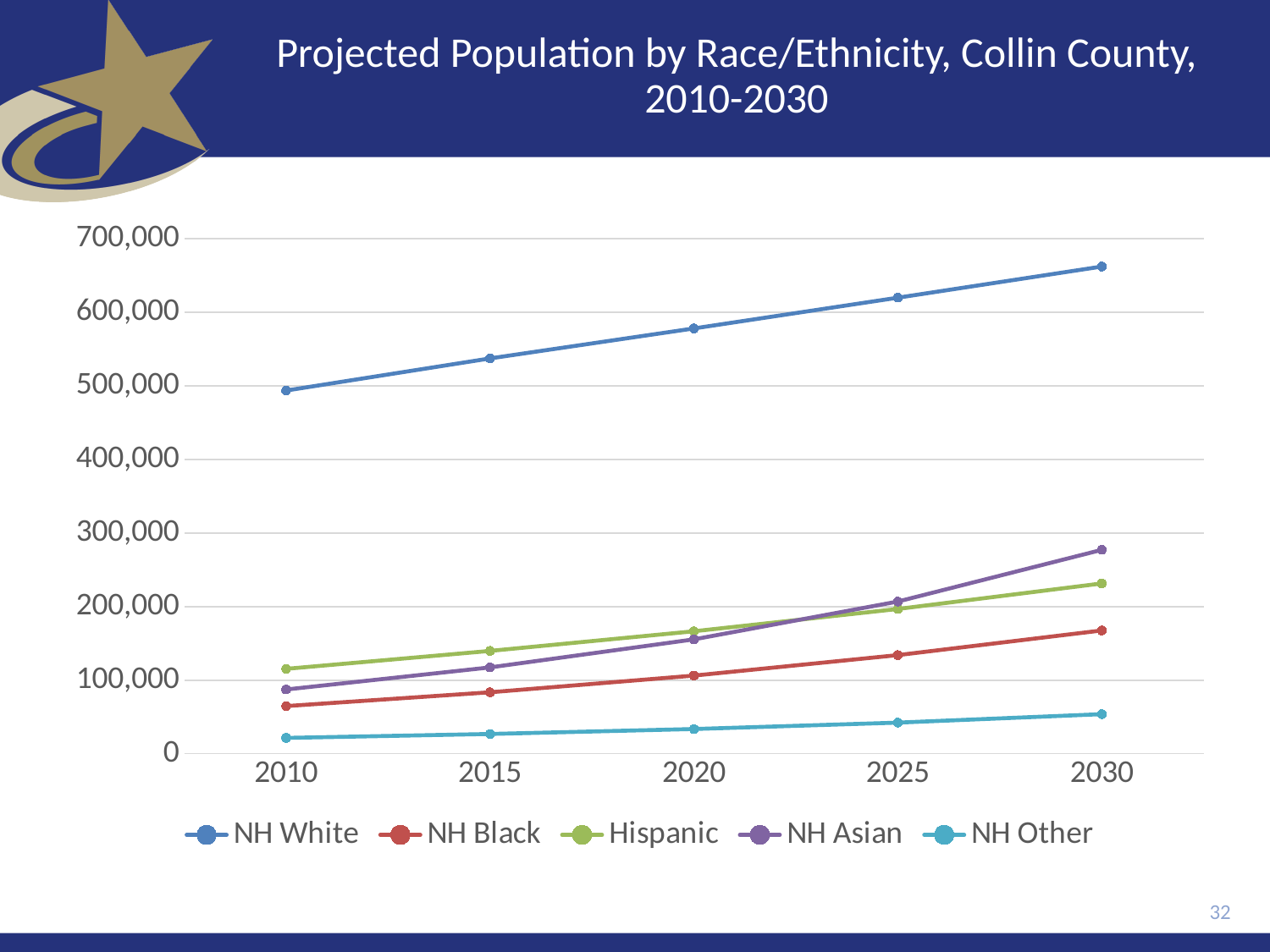
Does the projected NH White population rise or fall from 2010 to 2030? rise What kind of chart is shown on the slide? line chart Is the projected NH Asian population in 2030 greater or less than 200,000? greater Is the projected Hispanic population in 2010 greater or less than 100,000? greater How many series does the legend list? 5 Is the projected NH Black population in 2030 greater or less than 200,000? less Which race/ethnicity group has the lowest projected population in 2030? NH Other In 2010, which is larger: the projected Hispanic population or the projected NH Asian population? Hispanic How many years are plotted along the x axis? 5 Which race/ethnicity group has the highest projected population in 2030? NH White In 2030, which is larger: the projected NH Asian population or the projected Hispanic population? NH Asian